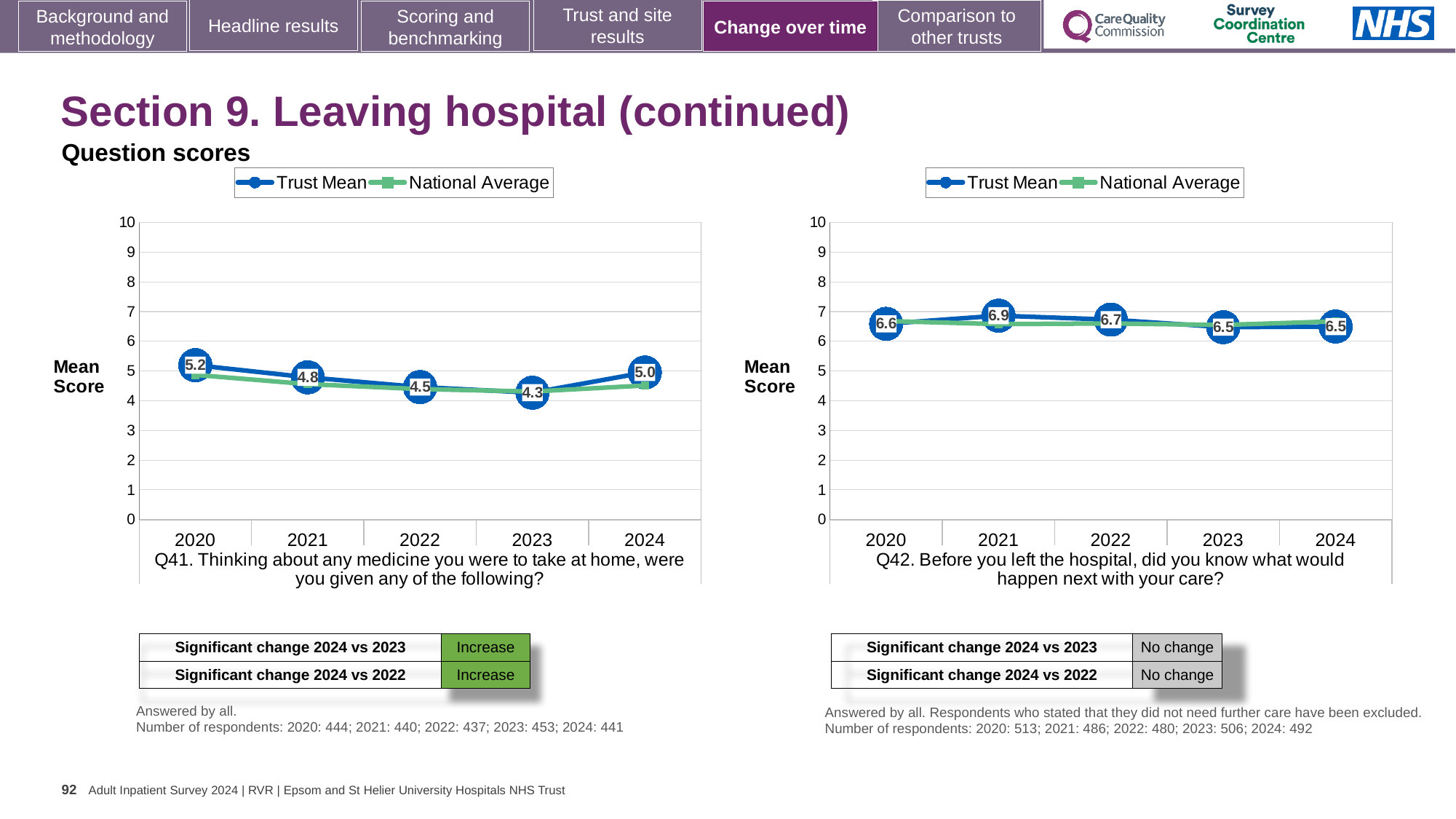
What kind of chart is the Q41 chart (left)? Line chart In the Q41 chart (left), which year has the lowest Trust Mean score? 2023 In the Q41 chart (left), does the Trust Mean score rise or fall from 2020 to 2023? Fall In the Q42 chart (right), what is the Trust Mean score for 2021? 6.9 In the Q41 chart (left), what is the difference between the Trust Mean scores for 2020 and 2023? 0.9 In the Q41 chart (left), what is the Trust Mean score for 2023? 4.3 How many series does the legend of the Q42 chart (right) list? 2 In the Q42 chart (right), which is larger, the Trust Mean score for 2020 or for 2021? 2021 In the Q42 chart (right), is the National Average value for 2024 greater or less than 6? greater In the Q42 chart (right), which year has the highest Trust Mean score? 2021 How many years are plotted on the x axis of the Q41 chart (left)? 5 In the Q41 chart (left), what is the Trust Mean score for 2024? 5.0